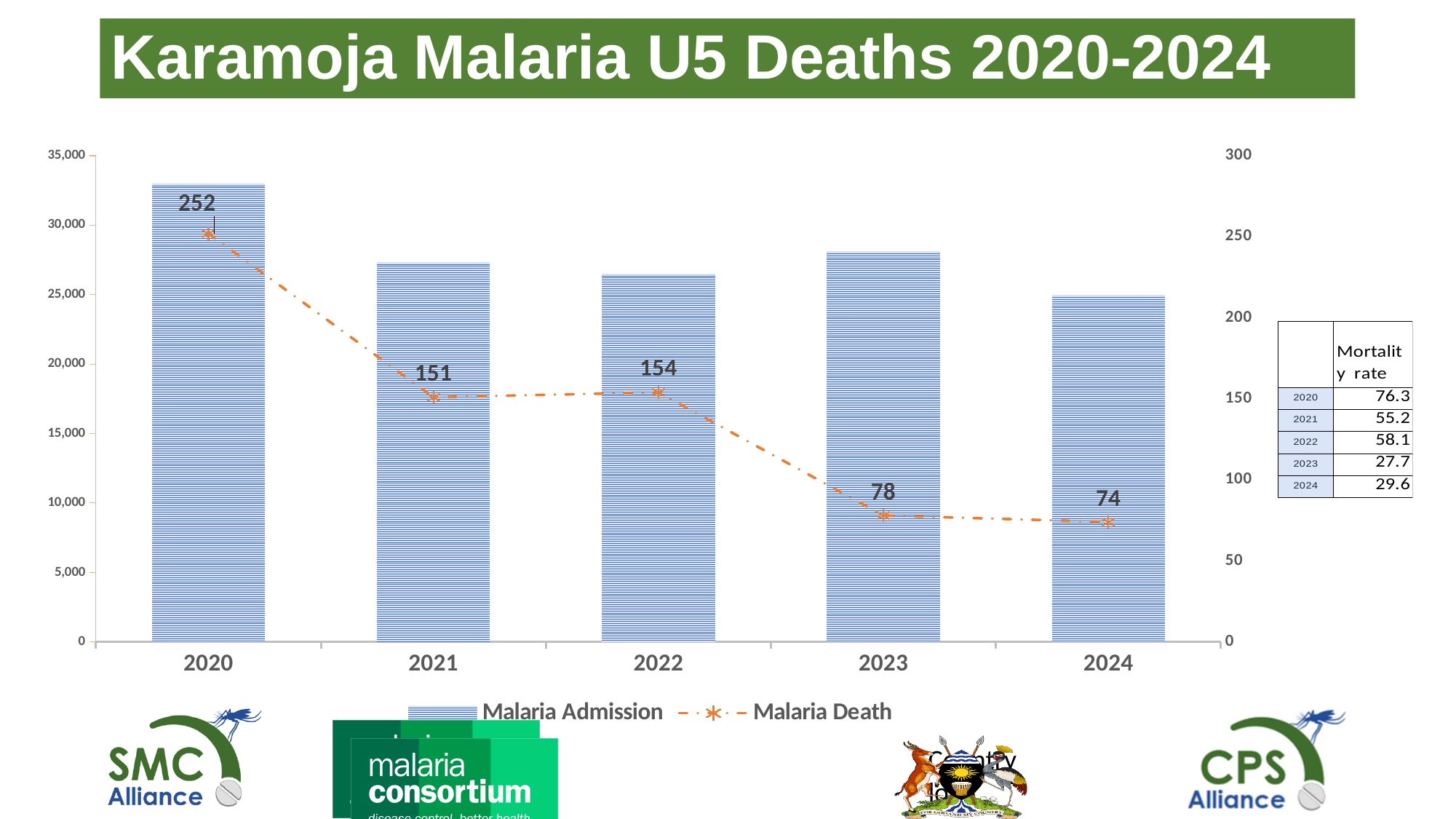
What is the difference between the Malaria Death values for 2020 and 2024? 178 What is the Malaria Death value for 2020? 252 Does the Malaria Death line generally rise or fall from 2020 to 2024? fall What is the Malaria Death value for 2023? 78 Which year has the larger Malaria Death value, 2021 or 2022? 2022 How many series does the legend list? 2 Which year has the lowest Malaria Death value? 2024 Which year has the tallest Malaria Admission bar? 2020 Is the Malaria Admission value for 2021 greater or less than 25,000? greater Which year has the highest Malaria Death value? 2020 Is the Malaria Admission value for 2020 greater or less than 30,000? greater How many years are shown on the x axis? 5